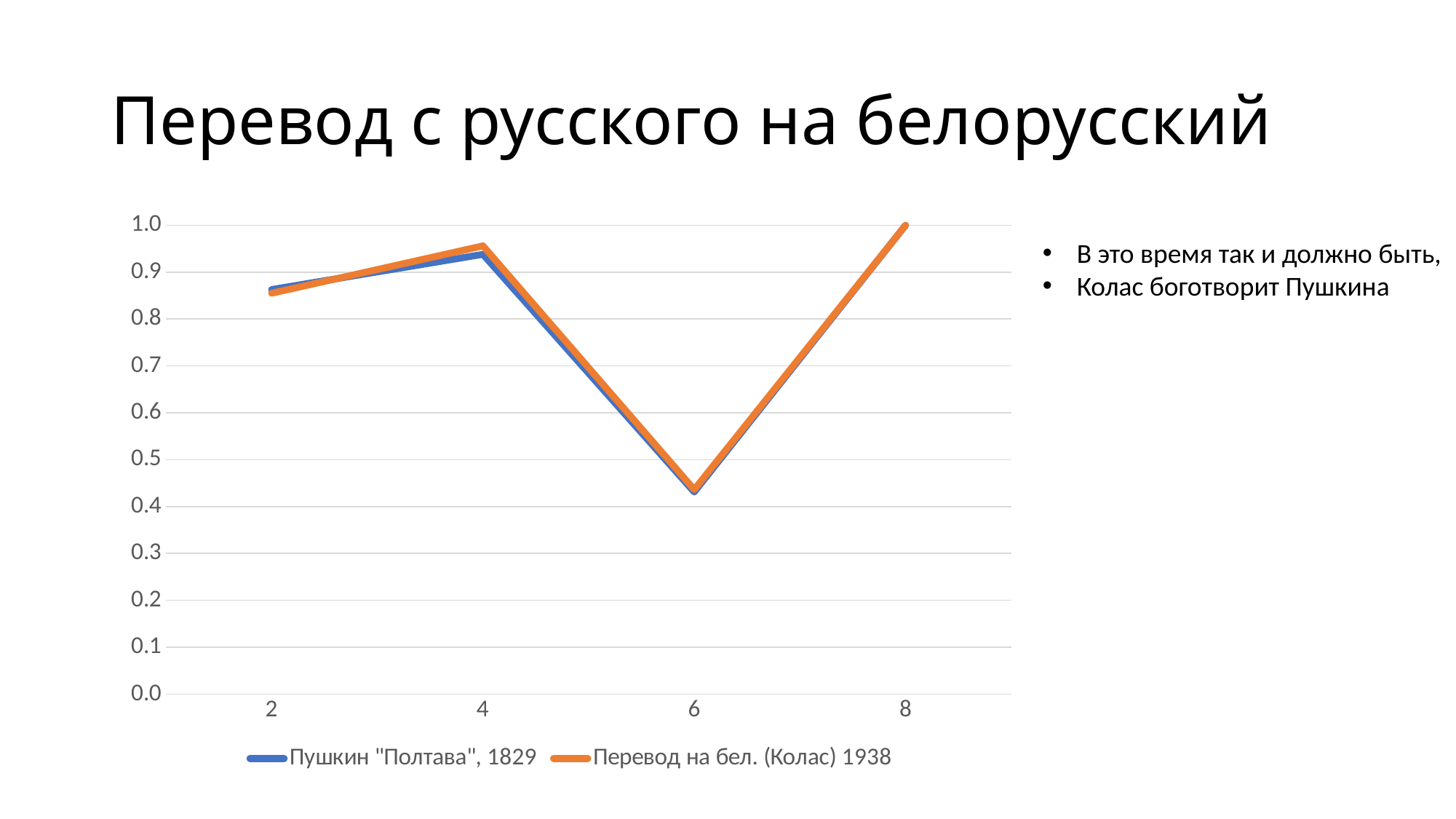
Do the values of both series rise or fall between x = 6 and x = 8? rise What colour is the line for the series "Пушкин "Полтава", 1829"? blue At which x value does the series "Пушкин "Полтава", 1829" reach its lowest value? 6 Is the value for "Перевод на бел. (Колас) 1938" at x = 4 greater or less than 0.9? greater Is the value for "Пушкин "Полтава", 1829" at x = 6 greater or less than 0.5? less At which x value does the series "Перевод на бел. (Колас) 1938" reach its highest value? 8 Is the value for "Пушкин "Полтава", 1829" at x = 2 greater or less than 0.8? greater How many series does the legend list? 2 Do the values of both series rise or fall between x = 4 and x = 6? fall For the series "Перевод на бел. (Колас) 1938", which is larger: the value at x = 4 or the value at x = 6? x = 4 How many points are plotted along the x axis for each series? 4 What kind of chart is shown on the slide? line chart